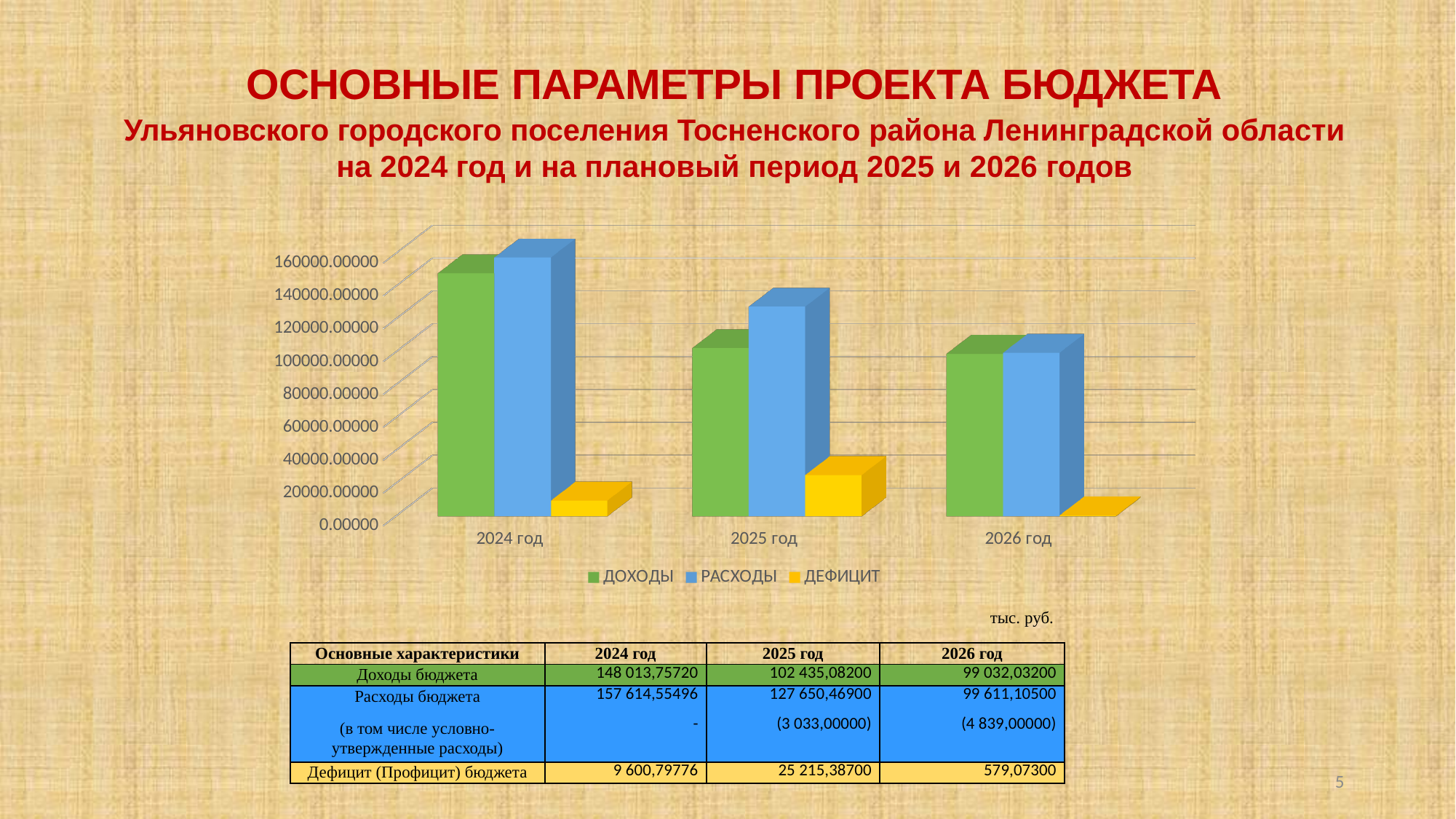
Is the value of РАСХОДЫ for 2025 год greater or less than 120000? greater How many year categories are shown on the x axis of the chart? 3 For 2024 год, which is larger: ДОХОДЫ or РАСХОДЫ? РАСХОДЫ In which year is ДОХОДЫ the highest? 2024 год In which year is ДЕФИЦИТ the lowest? 2026 год How many series does the chart legend list? 3 What is the value of ДОХОДЫ for 2024 год (as printed in the table)? 148 013,75720 What is the difference between РАСХОДЫ and ДОХОДЫ for 2024 год? 9 600,79776 What kind of chart is shown on the slide? bar chart Do the ДОХОДЫ values rise or fall from 2024 год to 2026 год? fall What is the value of ДЕФИЦИТ for 2026 год (as printed in the table)? 579,07300 What is the value of РАСХОДЫ for 2025 год (as printed in the table)? 127 650,46900